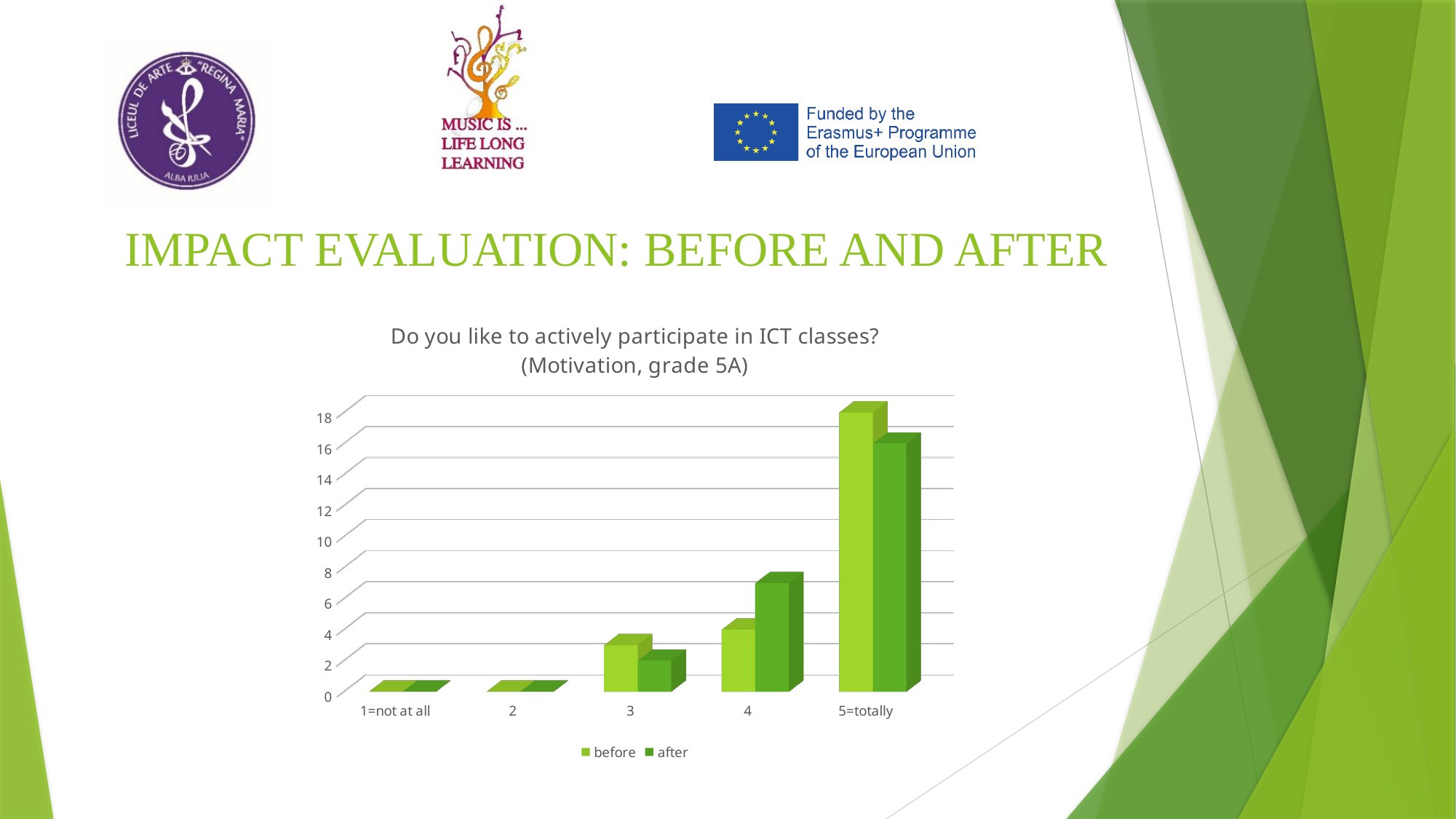
For category 4, which is larger: the 'before' value or the 'after' value? after For category 5=totally, which is larger: the 'before' value or the 'after' value? before Do the 'after' values generally rise or fall from 1=not at all to 5=totally? rise Which category has the highest value for the 'after' series? 5=totally What kind of chart is shown on the slide? bar chart Which category has the highest value for the 'before' series? 5=totally What question is the chart titled with? Do you like to actively participate in ICT classes? (Motivation, grade 5A) Is the 'before' value for 4 greater or less than 6? less How many categories are shown on the x axis? 5 Is the 'before' value for 5=totally greater or less than 16? greater Is the 'after' value for 3 greater or less than 4? less How many series does the legend list? 2